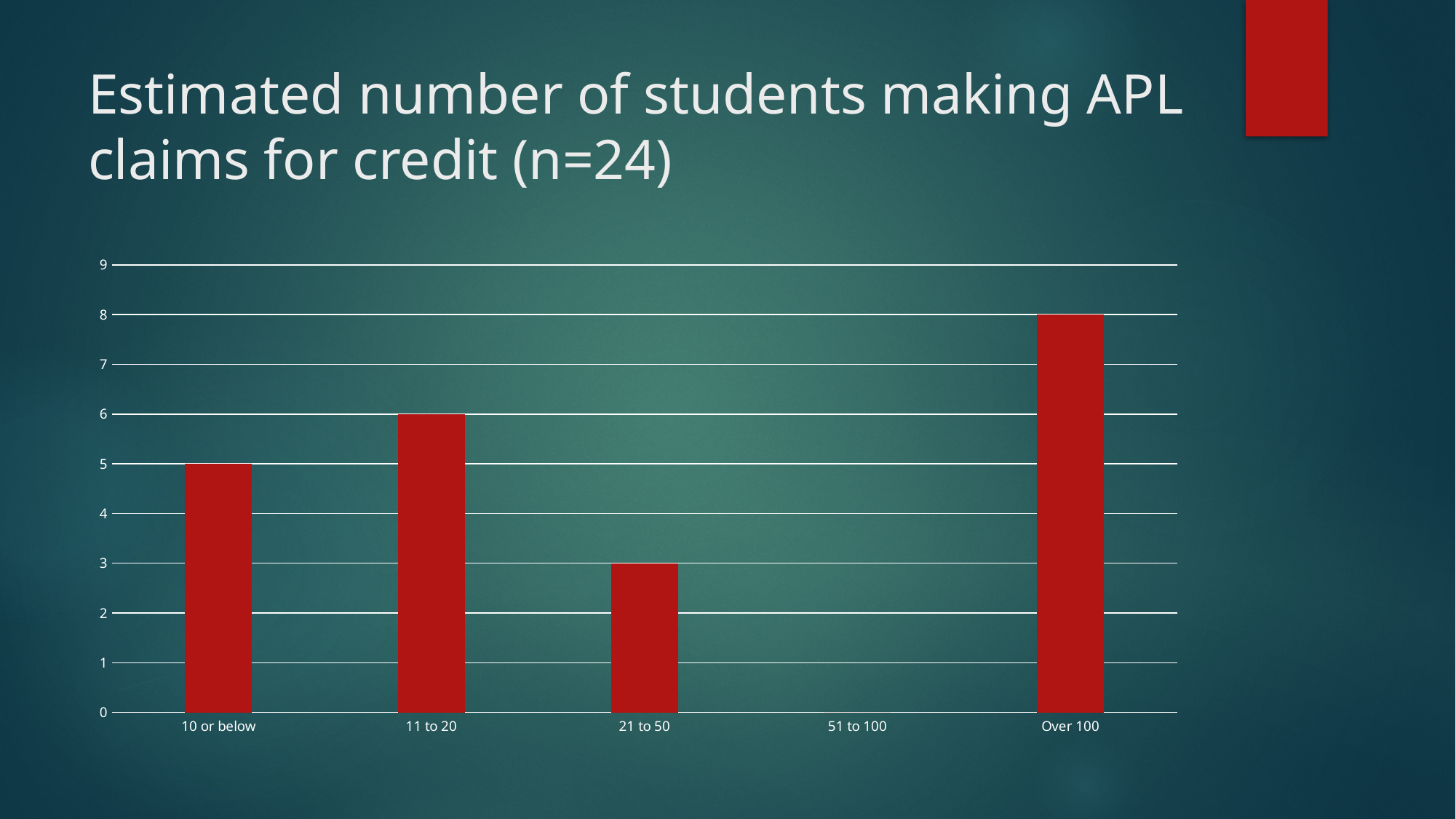
Is the value for 'Over 100' greater or less than 7? greater What is the title of the chart on the slide? Estimated number of students making APL claims for credit (n=24) Which category has the highest value? Over 100 How many categories are shown on the x axis? 5 Which is larger, the value for '10 or below' or the value for '11 to 20'? 11 to 20 What kind of chart is shown on the slide? Bar chart What is the value for the 'Over 100' category? 8 What is the difference between the values for 'Over 100' and '21 to 50'? 5 Which category has the lowest value? 51 to 100 What is the value for the '10 or below' category? 5 What is the value for the '11 to 20' category? 6 What is the value for the '21 to 50' category? 3